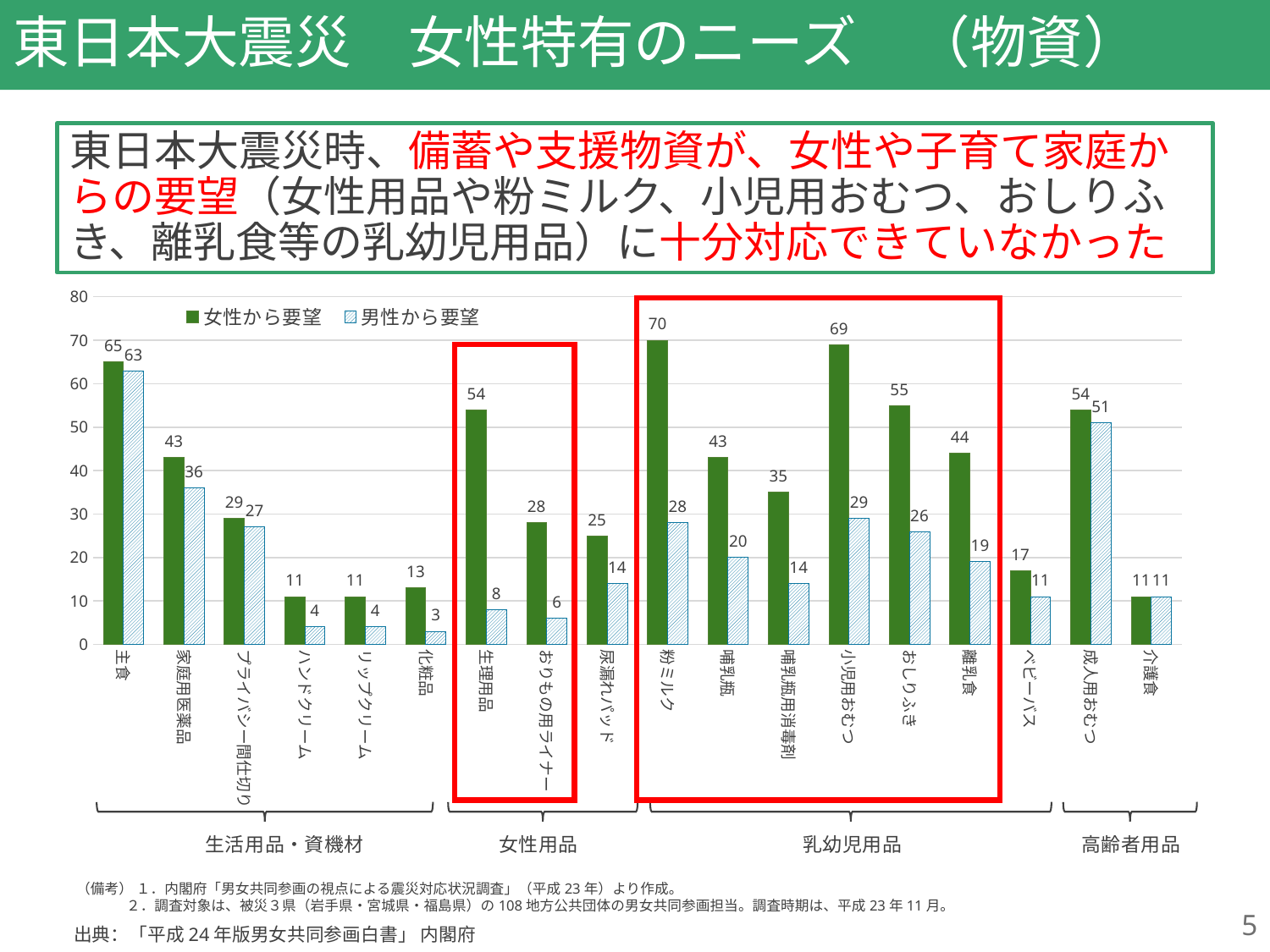
What is the value of 女性から要望 for 粉ミルク? 70 How many categories are plotted along the x axis? 18 Which category has the lowest value for 男性から要望? 化粧品 What are the two legend entries of the chart? 女性から要望, 男性から要望 What is the difference between 女性から要望 and 男性から要望 for 小児用おむつ? 40 Which category has the highest value for 女性から要望? 粉ミルク Which is larger for おしりふき: 女性から要望 or 男性から要望? 女性から要望 What is the difference between 女性から要望 and 男性から要望 for 主食? 2 What is the value of 女性から要望 for 成人用おむつ? 54 What is the value of 男性から要望 for 生理用品? 8 How many series does the legend list? 2 What type of chart is shown on the slide? bar chart